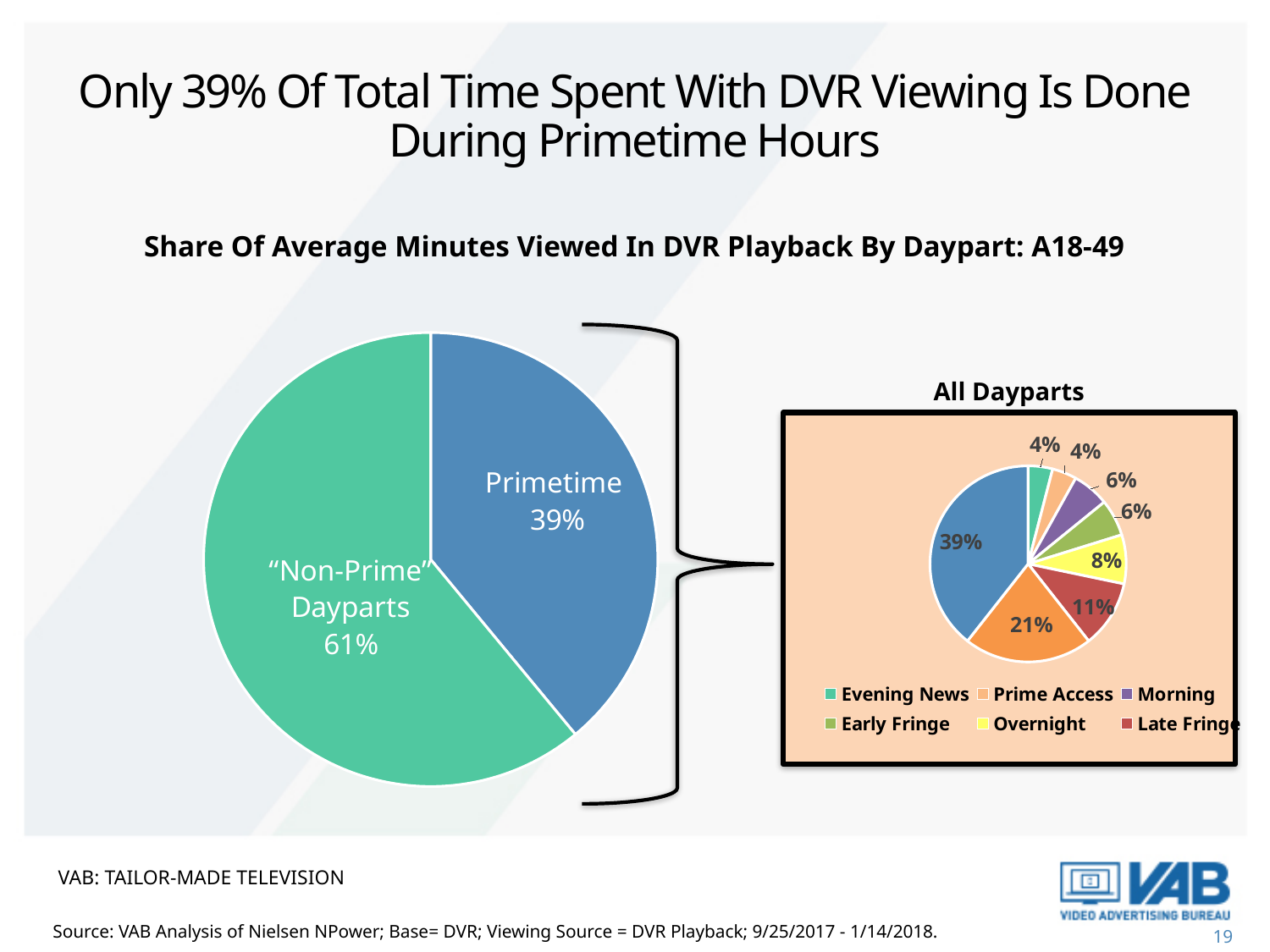
What is the subtitle describing the charts on this slide? Share Of Average Minutes Viewed In DVR Playback By Daypart: A18-49 In the All Dayparts chart, what share is labelled for Late Fringe? 11% In the left pie chart, what share is labelled for "Non-Prime" Dayparts? 61% In the All Dayparts chart, how many entries does the legend list? 6 In the All Dayparts chart, what share is labelled for Overnight? 8% In the left pie chart, what share is labelled for Primetime? 39% How many slices does the left pie chart have? 2 How many slices does the All Dayparts pie chart have? 8 In the left pie chart, which slice is larger, Primetime or "Non-Prime" Dayparts? "Non-Prime" Dayparts What type of chart is used on this slide? Pie chart In the left pie chart, by how many percentage points does "Non-Prime" Dayparts exceed Primetime? 22 percentage points In the All Dayparts chart, what is the value of the largest slice? 39%